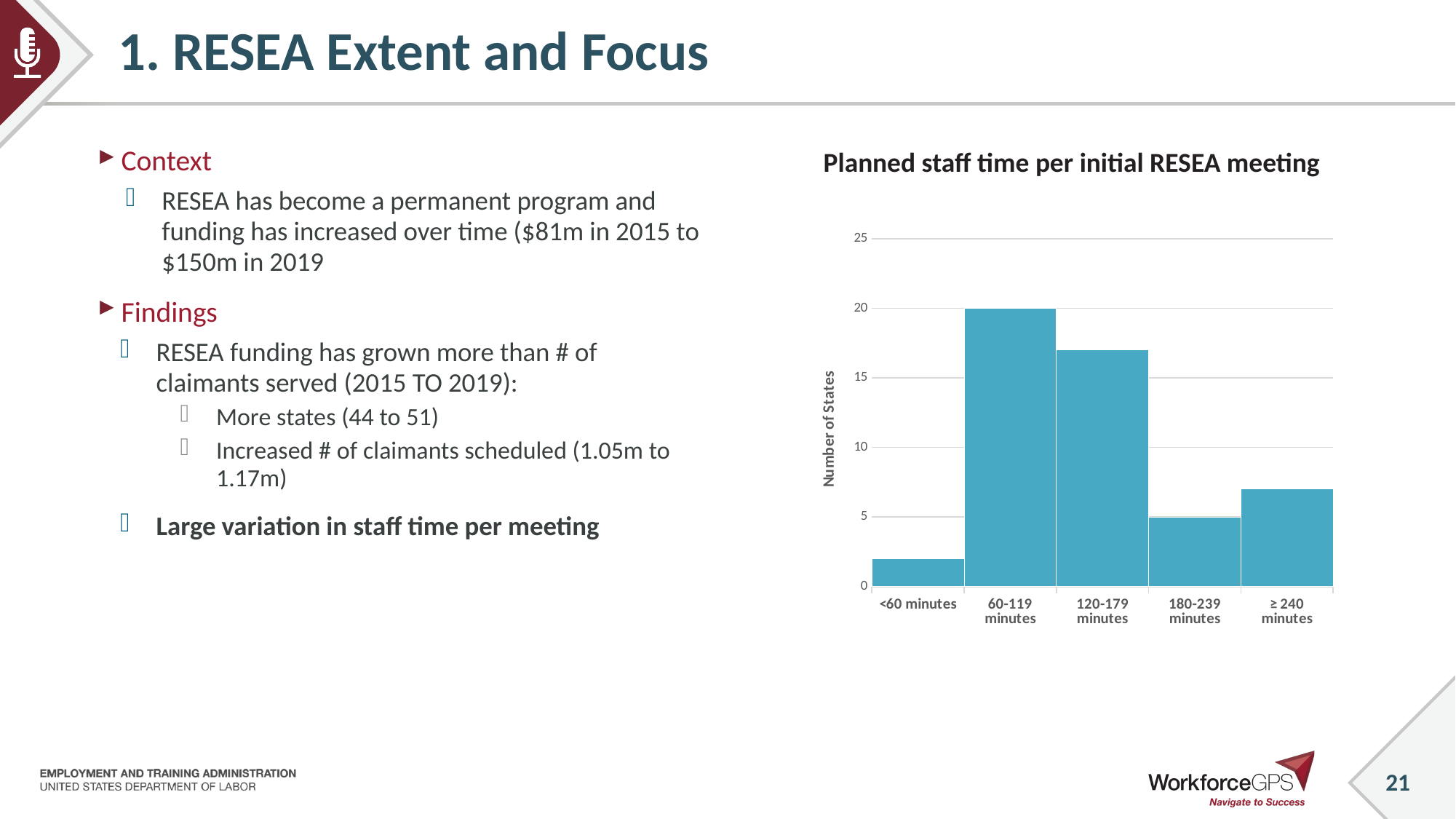
Is the number of states for <60 minutes greater or less than 5? less What is the title of the chart? Planned staff time per initial RESEA meeting Which has more states: 120-179 minutes or 180-239 minutes? 120-179 minutes How many states planned 60-119 minutes of staff time per initial RESEA meeting? 20 How many categories are shown on the x axis of the chart? 5 What kind of chart is shown on the slide? bar chart Is the number of states for 120-179 minutes greater or less than 15? greater Which category has the lowest number of states? <60 minutes Which category has the highest number of states? 60-119 minutes How many states planned 180-239 minutes of staff time per initial RESEA meeting? 5 What is the difference in number of states between 60-119 minutes and 180-239 minutes? 15 Is the number of states for ≥ 240 minutes greater or less than 5? greater